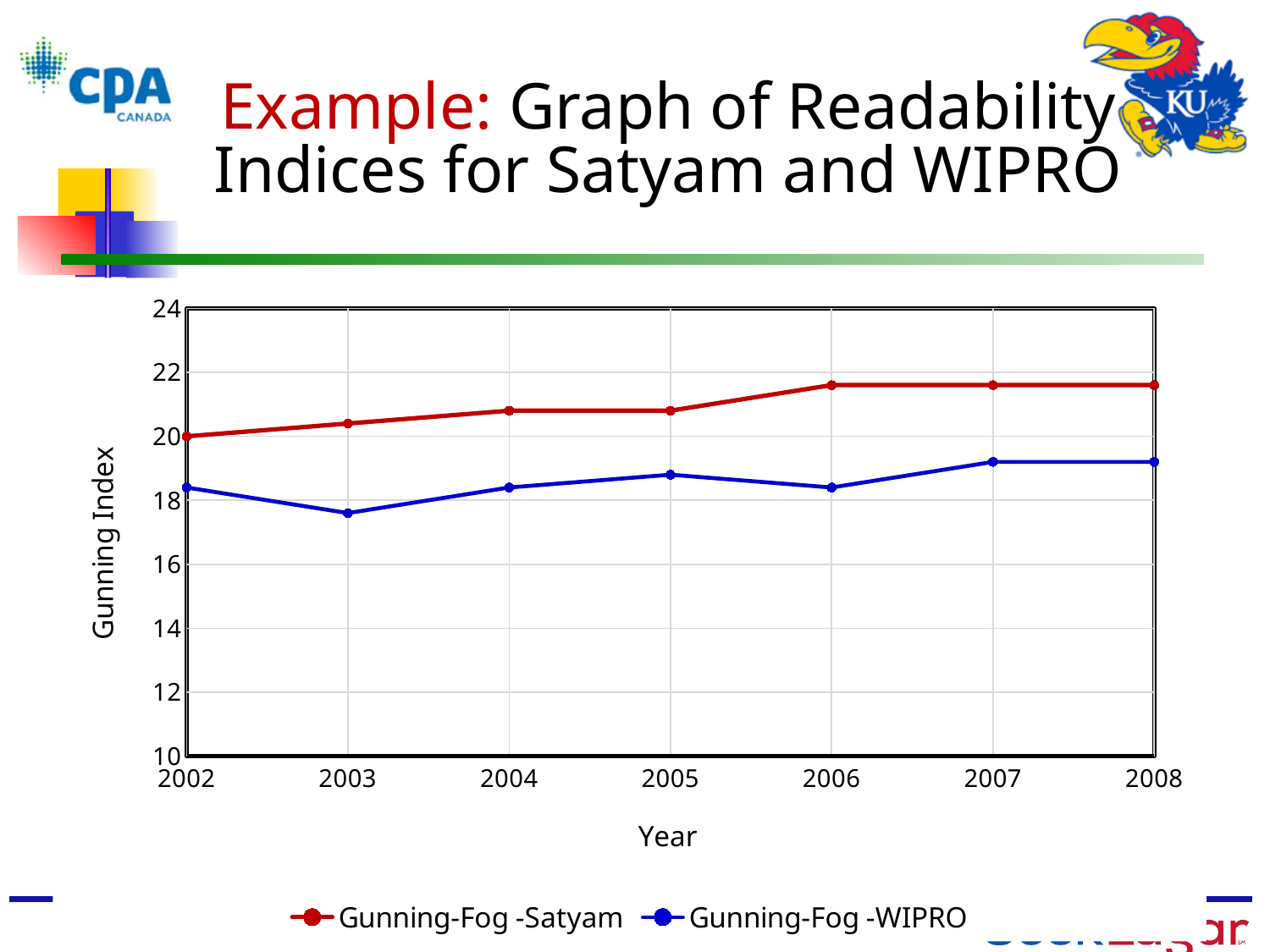
In which year is the Gunning-Fog -WIPRO value lowest? 2003 What colour is the Gunning-Fog -WIPRO line? blue Is the Gunning-Fog -Satyam value for 2006 greater or less than 20? greater Is the Gunning-Fog -WIPRO value for 2003 greater or less than 18? less What is the Gunning-Fog -Satyam value in 2002? 20 What kind of chart is shown on the slide? line chart Does the Gunning-Fog -Satyam series rise or fall from 2002 to 2008? rise Is the Gunning-Fog -WIPRO value for 2005 greater or less than 18? greater How many years are plotted along the x axis? 7 In 2006, which series has the higher Gunning Index, Gunning-Fog -Satyam or Gunning-Fog -WIPRO? Gunning-Fog -Satyam How many series does the legend list? 2